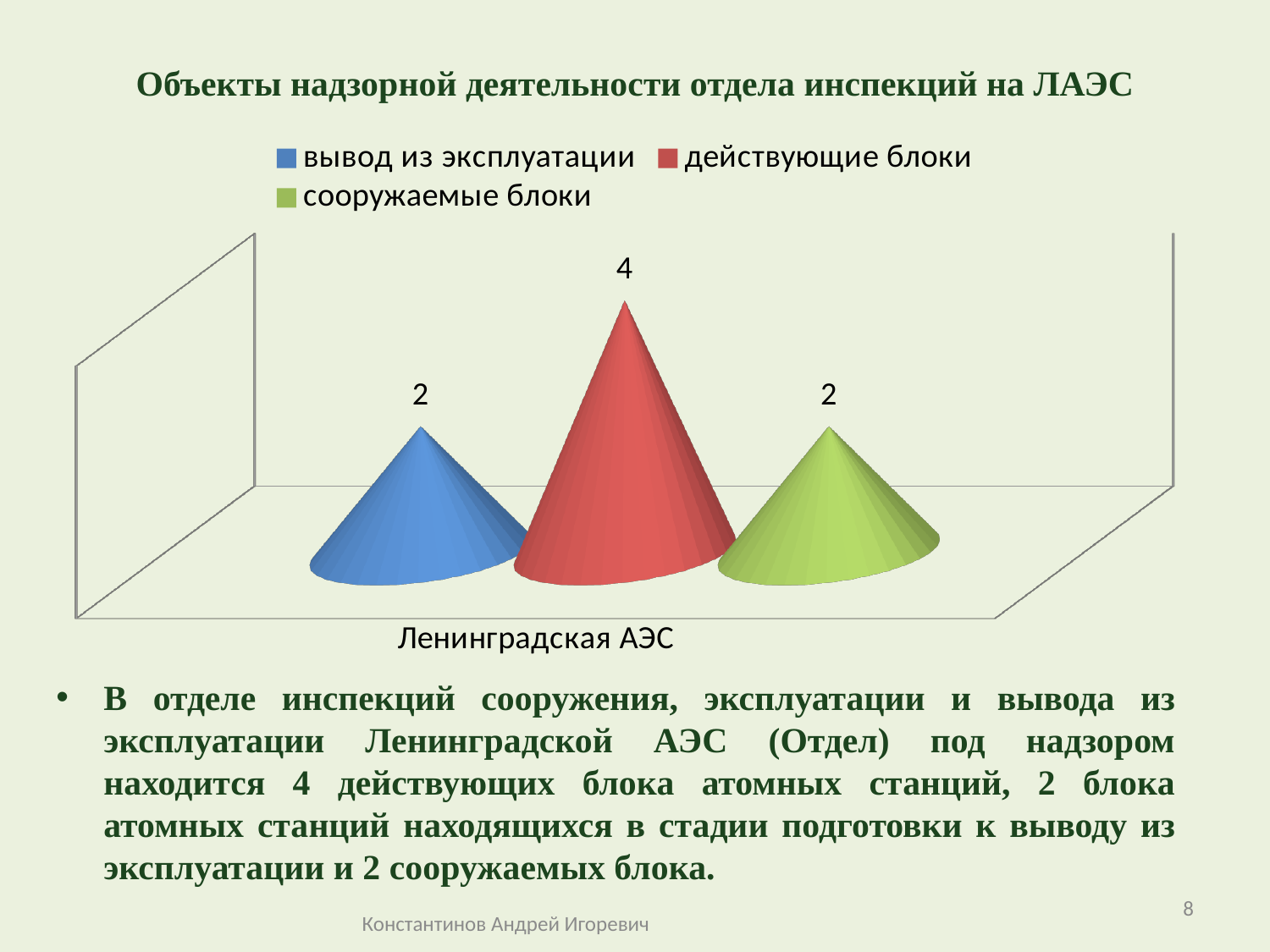
Which series has the highest value? действующие блоки What is the title of the chart? Объекты надзорной деятельности отдела инспекций на ЛАЭС What kind of chart is shown on the slide? bar chart What is the difference between the value for "действующие блоки" and the value for "сооружаемые блоки"? 2 What is the value for the series "действующие блоки"? 4 What is the total of the three values plotted for Ленинградская АЭС? 8 How many series does the legend list? 3 How many categories are shown on the x axis? 1 What is the name of the category shown on the x axis? Ленинградская АЭС What is the value for the series "вывод из эксплуатации"? 2 Which is larger: the value for "действующие блоки" or the value for "вывод из эксплуатации"? действующие блоки What is the value for the series "сооружаемые блоки"? 2